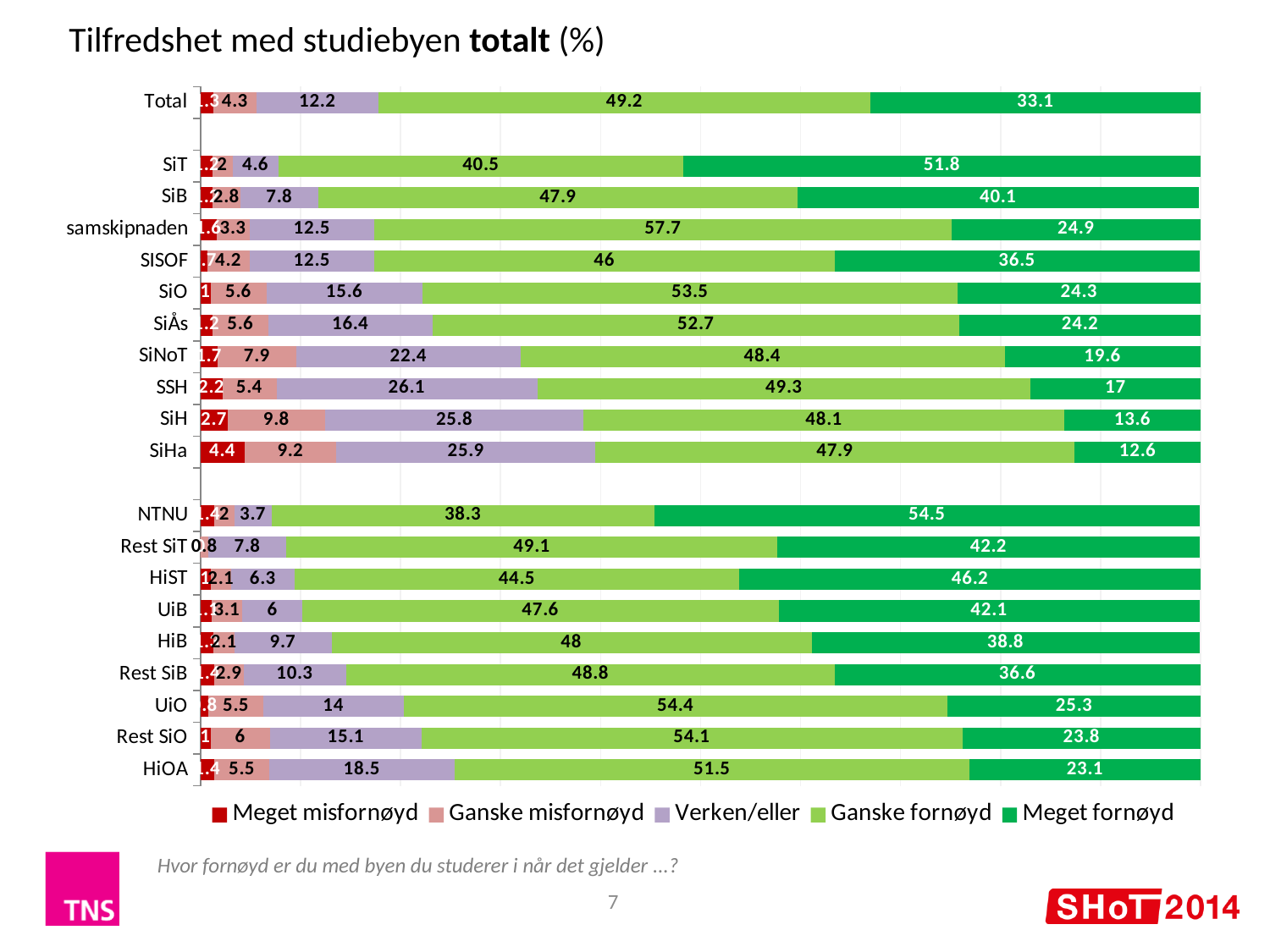
How many categories (rows) are plotted in the chart? 20 What kind of chart is shown on the slide? Stacked bar chart What is the difference between the 'Meget fornøyd' values for SiT and SiB? 11.7 What is the 'Meget fornøyd' value for NTNU? 54.5 What is the 'Ganske misfornøyd' value for SiH? 9.8 What is the 'Meget misfornøyd' value for SiHa? 4.4 Which category has the lowest 'Meget fornøyd' value? SiHa What is the 'Ganske fornøyd' value for samskipnaden? 57.7 Which has the larger 'Verken/eller' value, SiNoT or SiO? SiNoT How many series does the legend list? 5 Which category has the highest 'Meget fornøyd' value? NTNU